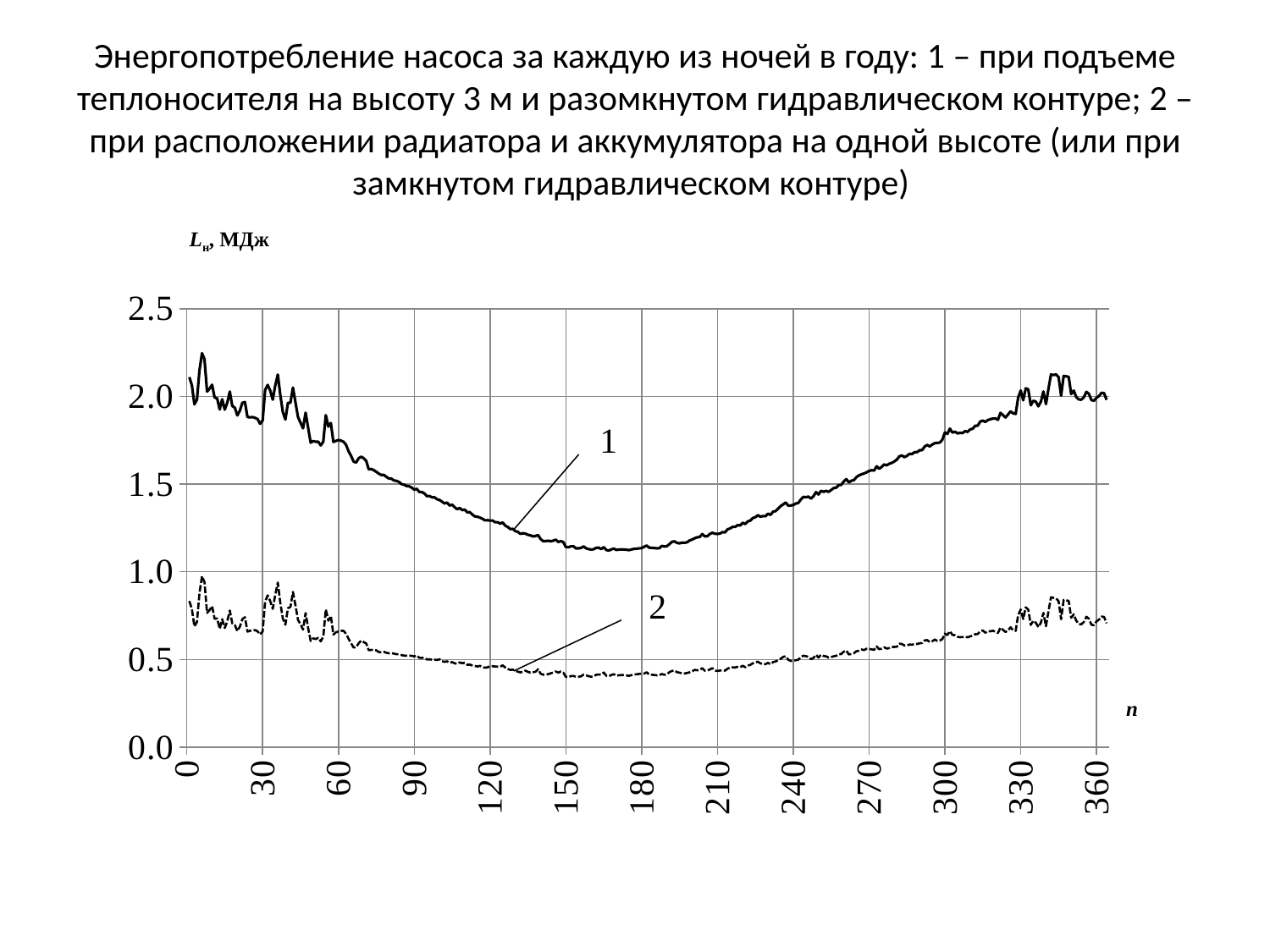
How many curves (series) are plotted on the chart? 2 Which curve is drawn with a dashed line, 1 or 2? 2 Is the value of curve 1 at n = 300 greater or less than 1.5? greater Is the value of curve 1 at n = 180 greater or less than 1.5? less Is the value of curve 2 at n = 330 greater or less than 1.0? less Does curve 1 rise or fall as n goes from 0 to 180? fall What kind of chart is shown on the slide? line chart At n = 180, which curve has the larger value, curve 1 or curve 2? curve 1 Does curve 2 rise or fall as n goes from 180 to 360? rise